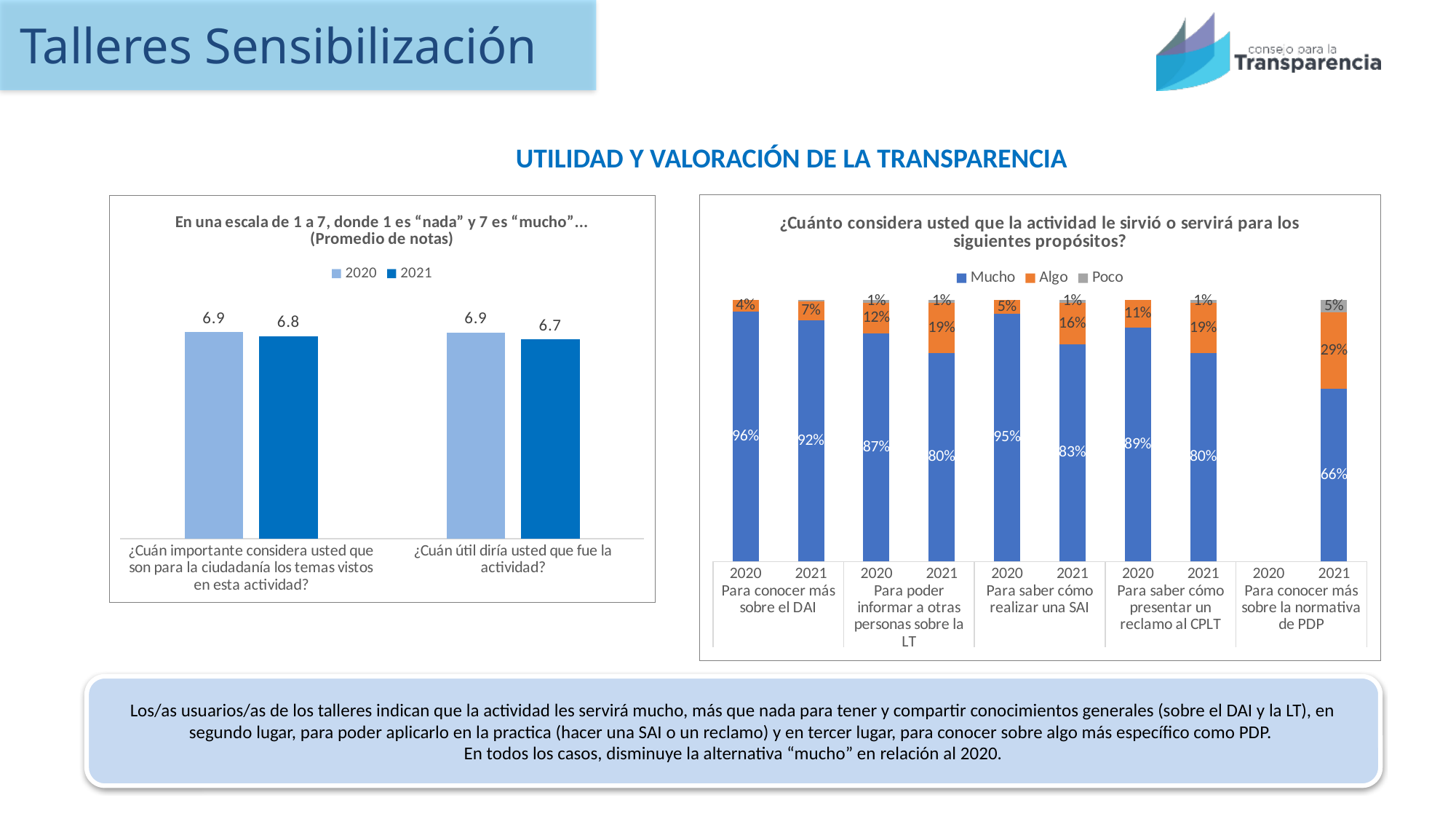
In the left chart (scale 1 to 7), how many series does the legend list? 2 In the right chart (¿Cuánto considera usted que la actividad le sirvió...?), what is the "Algo" percentage for 2021 under "Para saber cómo realizar una SAI"? 16% In the right chart (¿Cuánto considera usted que la actividad le sirvió...?), which bar has the highest "Mucho" percentage? 2020, Para conocer más sobre el DAI (96%) In the left chart (scale 1 to 7), what kind of chart is it? Bar chart In the left chart (scale 1 to 7), what is the 2021 value for "¿Cuán útil diría usted que fue la actividad?"? 6.7 In the right chart (¿Cuánto considera usted que la actividad le sirvió...?), what is the difference between the 2020 and 2021 "Mucho" percentages for "Para saber cómo realizar una SAI"? 12% In the right chart (¿Cuánto considera usted que la actividad le sirvió...?), which bar has the lowest "Mucho" percentage? 2021, Para conocer más sobre la normativa de PDP (66%) In the left chart (scale 1 to 7), what is the difference between the 2020 and 2021 values for "¿Cuán útil diría usted que fue la actividad?"? 0.2 In the right chart (¿Cuánto considera usted que la actividad le sirvió...?), what is the "Mucho" percentage for 2021 under "Para conocer más sobre la normativa de PDP"? 66% In the left chart (scale 1 to 7), what is the 2020 value for "¿Cuán importante considera usted que son para la ciudadanía los temas vistos en esta actividad?"? 6.9 In the right chart (¿Cuánto considera usted que la actividad le sirvió...?), which is larger: the 2020 "Algo" value for "Para poder informar a otras personas sobre la LT" or the 2020 "Algo" value for "Para saber cómo presentar un reclamo al CPLT"? Para poder informar a otras personas sobre la LT (12%) In the right chart (¿Cuánto considera usted que la actividad le sirvió...?), how many series does the legend list? 3